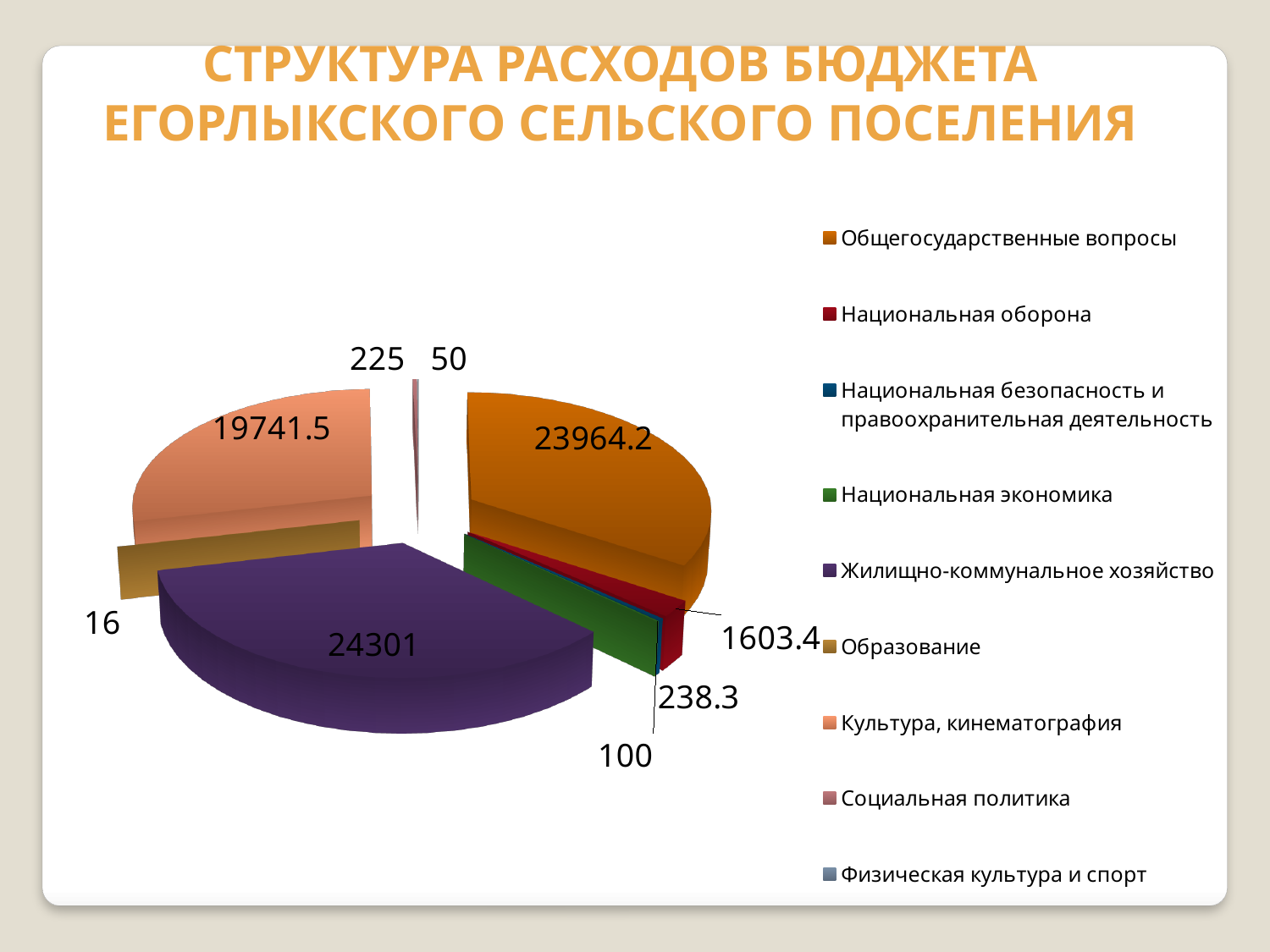
What is the value for Жилищно-коммунальное хозяйство? 24301 What kind of chart is shown on the slide? Pie chart How many categories does the legend list? 9 What is the difference between the values for Жилищно-коммунальное хозяйство and Общегосударственные вопросы? 336.8 Which is larger, the value for Социальная политика or the value for Физическая культура и спорт? Социальная политика What is the value for Национальная оборона? 1603.4 What is the value for Общегосударственные вопросы? 23964.2 What is the title of the chart on the slide? СТРУКТУРА РАСХОДОВ БЮДЖЕТА ЕГОРЛЫКСКОГО СЕЛЬСКОГО ПОСЕЛЕНИЯ What is the value for Культура, кинематография? 19741.5 What is the value for Образование? 16 Which category has the smallest value? Образование Which category has the largest slice of the pie? Жилищно-коммунальное хозяйство